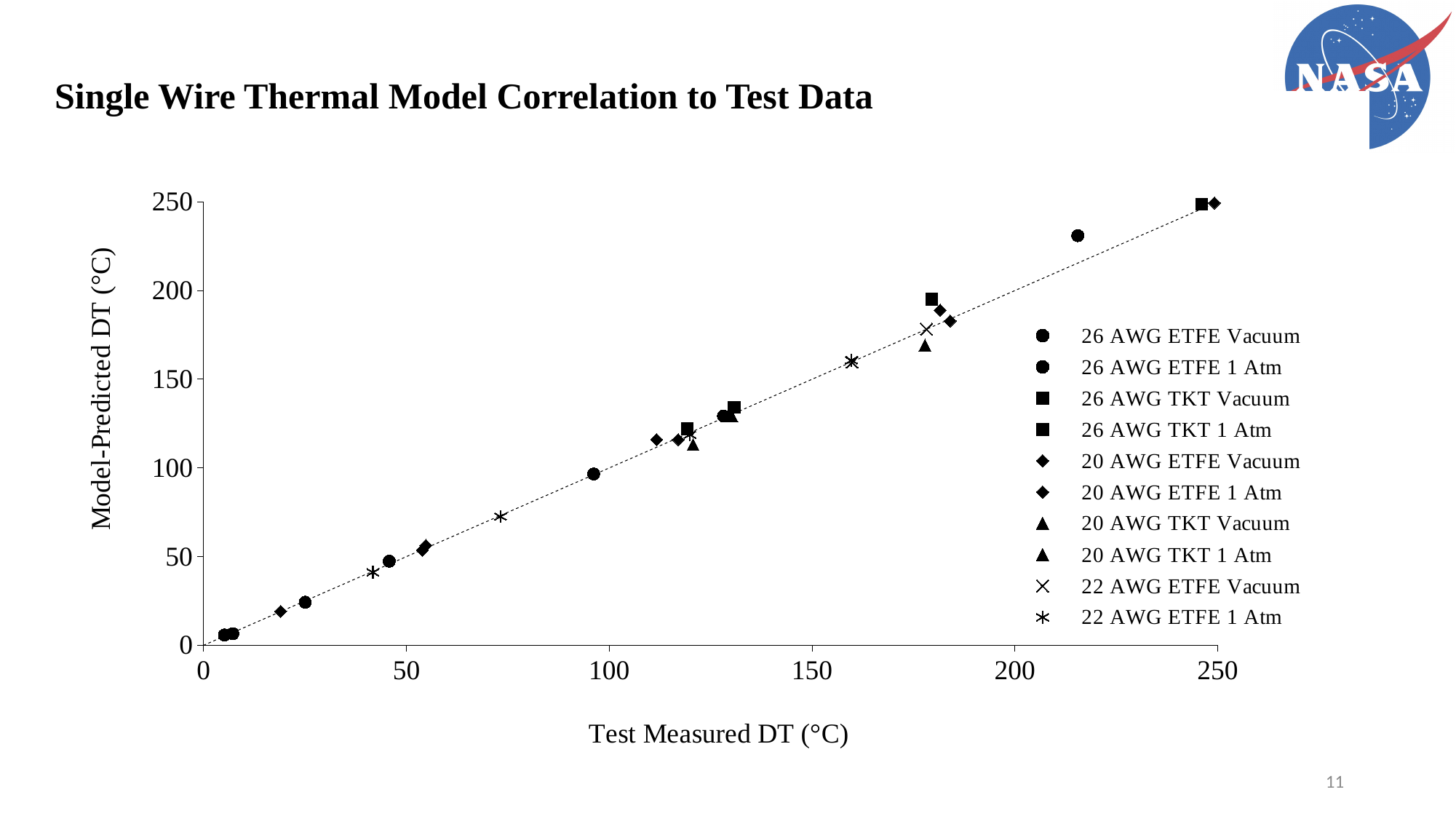
Is the model-predicted DT for the 22 AWG ETFE Vacuum point greater or less than 150? greater What is the label of the x axis? Test Measured DT (°C) How many 22 AWG ETFE 1 Atm (asterisk) points are plotted? 4 What kind of chart is shown on the slide? scatter chart Is the highest 22 AWG ETFE 1 Atm point's model-predicted DT greater or less than 150? greater What is the title of the slide's chart? Single Wire Thermal Model Correlation to Test Data How many series does the legend list? 10 What is the maximum value shown on the y axis? 250 Is the lowest 22 AWG ETFE 1 Atm point's model-predicted DT greater or less than 50? less How many 22 AWG ETFE Vacuum (×) points are plotted? 2 Do the model-predicted DT values rise or fall as the test measured DT increases along the x axis? rise